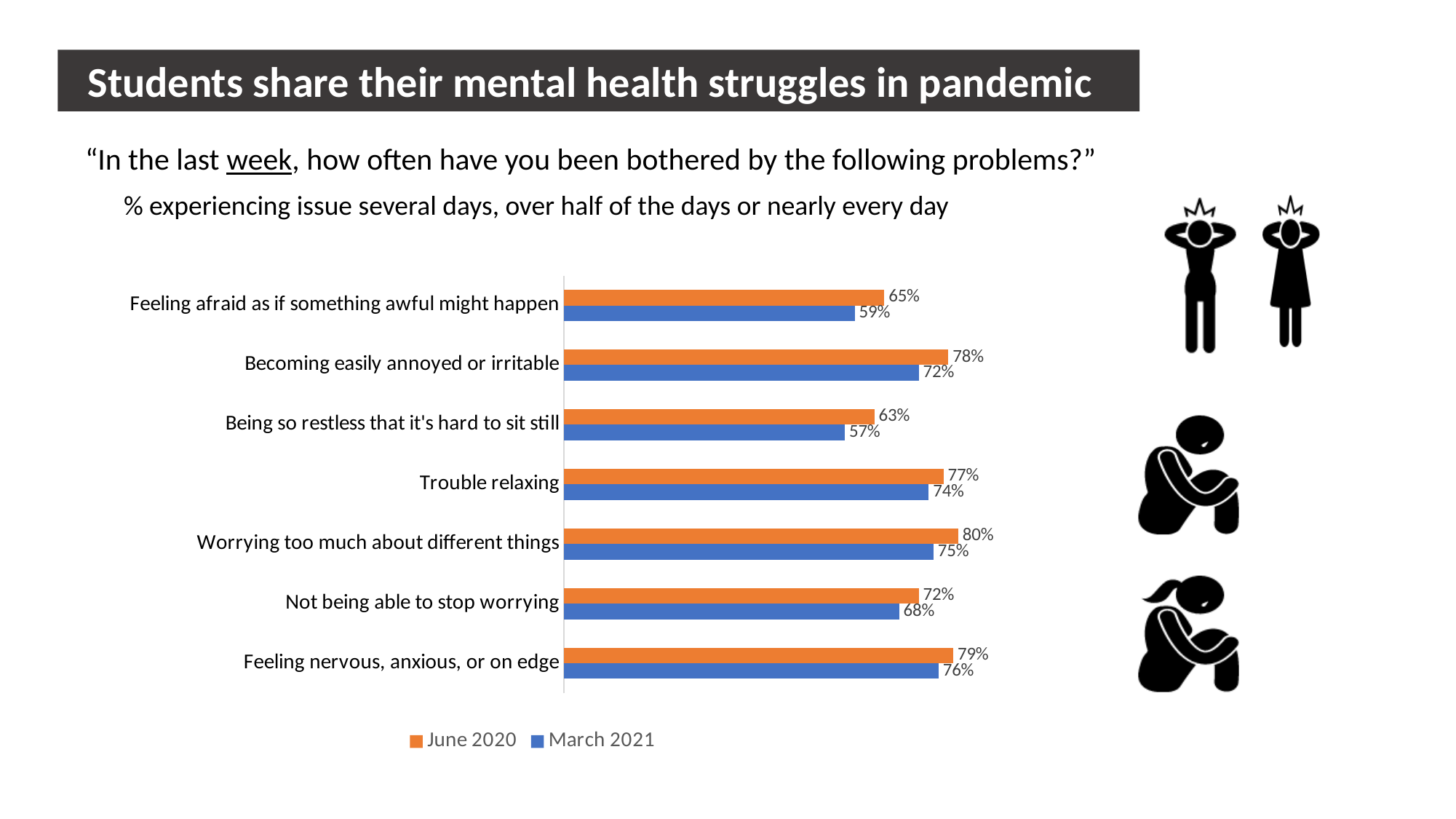
What is the difference between the June 2020 and March 2021 values for "Becoming easily annoyed or irritable"? 6% Which category has the highest June 2020 value? Worrying too much about different things Which series is shown in orange? June 2020 How many series does the legend list? 2 Which is larger for "Not being able to stop worrying": the June 2020 value or the March 2021 value? June 2020 What kind of chart is shown on the slide? Bar chart What is the March 2021 value for "Feeling afraid as if something awful might happen"? 59% What is the June 2020 value for "Feeling nervous, anxious, or on edge"? 79% Which category has the lowest March 2021 value? Being so restless that it's hard to sit still What is the June 2020 value for "Worrying too much about different things"? 80% How many categories are shown on the chart? 7 What is the March 2021 value for "Trouble relaxing"? 74%